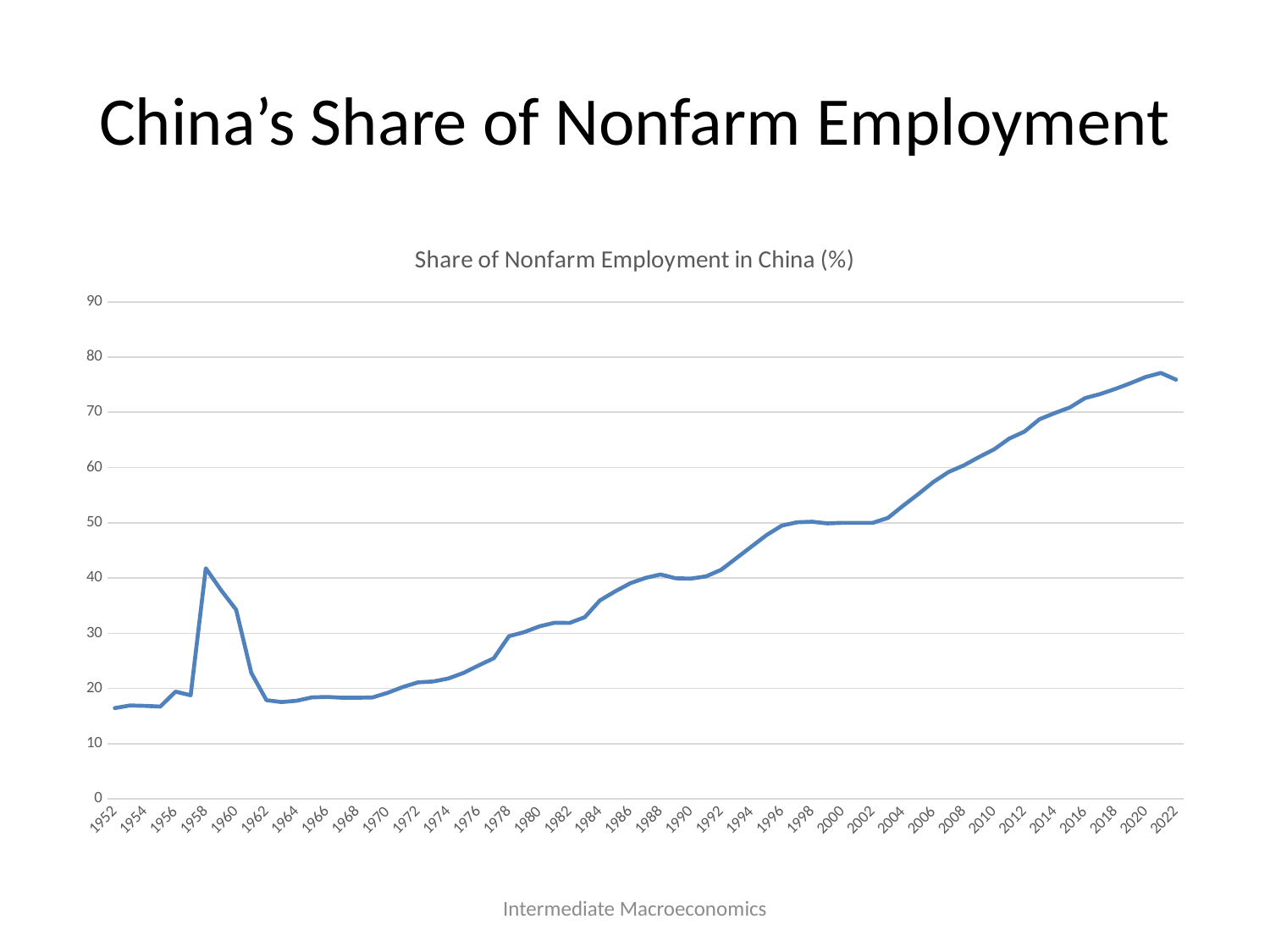
What is the highest value shown on the vertical axis? 90 Is the value for 2016 greater or less than 70? greater Is the value for 1952 greater or less than 20? less Is the value for 2012 greater or less than 60? greater In which year does the line reach its highest value? 2021 Overall, does the share of nonfarm employment rise or fall from 1952 to 2022? rise What kind of chart is shown on the slide? line chart Which year has the larger value, 1958 or 1962? 1958 What is the title printed above the chart? Share of Nonfarm Employment in China (%)